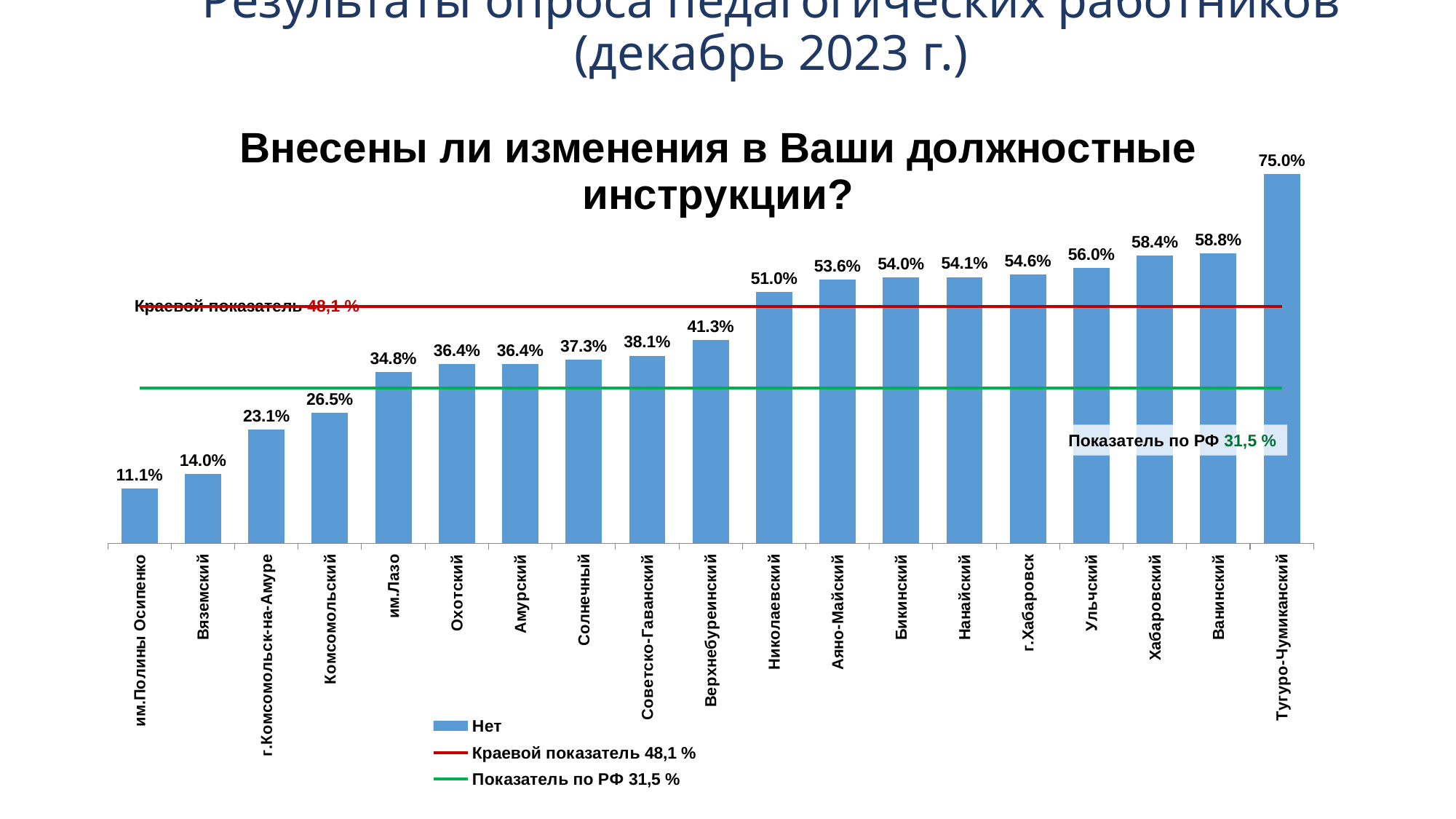
What is the value for г.Комсомольск-на-Амуре? 23.1% What is the difference between the values for Ванинский and Хабаровский? 0.4% What is the difference between the values for Тугуро-Чумиканский and им.Полины Осипенко? 63.9% What is the value for Николаевский? 51.0% Which category has the lowest value? им.Полины Осипенко Which category has the highest value? Тугуро-Чумиканский Which is larger, the value for Верхнебуреинский or the value for Солнечный? Верхнебуреинский What value does the red line labelled 'Краевой показатель' represent? 48,1 % What kind of chart is shown on the slide? bar chart How many entries does the legend list? 3 How many categories (bars) are shown in the chart? 19 What is the value for Тугуро-Чумиканский? 75.0%